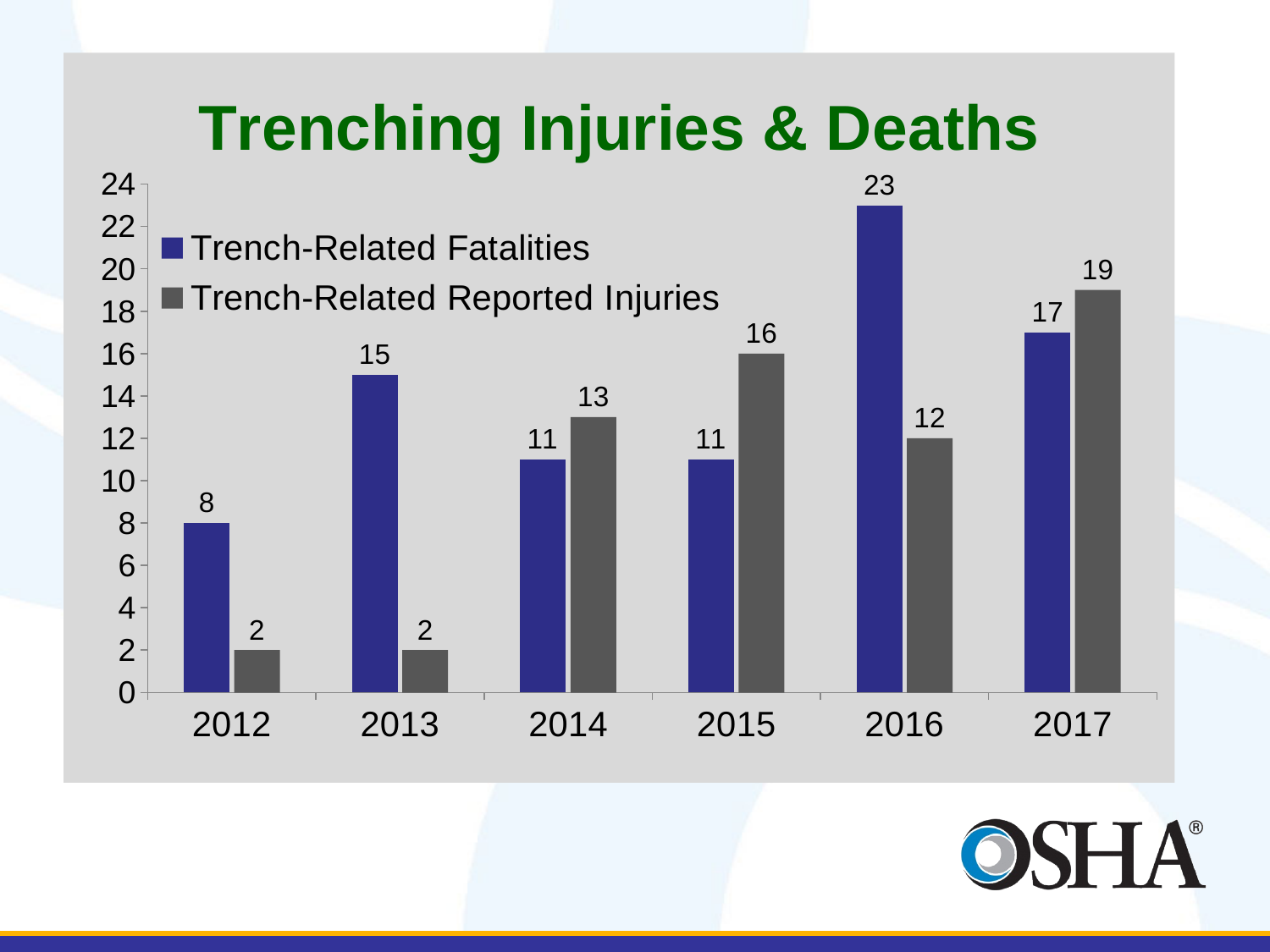
What is the value for Trench-Related Reported Injuries in 2013? 2 Which year has the lowest value for Trench-Related Fatalities? 2012 What is the title of the chart? Trenching Injuries & Deaths What is the difference between Trench-Related Fatalities and Trench-Related Reported Injuries in 2016? 11 What is the difference between Trench-Related Fatalities in 2013 and in 2012? 7 How many years are shown on the x axis? 6 What is the value for Trench-Related Reported Injuries in 2017? 19 Which year has the highest value for Trench-Related Fatalities? 2016 Which is larger in 2015, Trench-Related Fatalities or Trench-Related Reported Injuries? Trench-Related Reported Injuries How many series does the legend list? 2 What is the value for Trench-Related Fatalities in 2016? 23 What kind of chart is shown on the slide? Bar chart